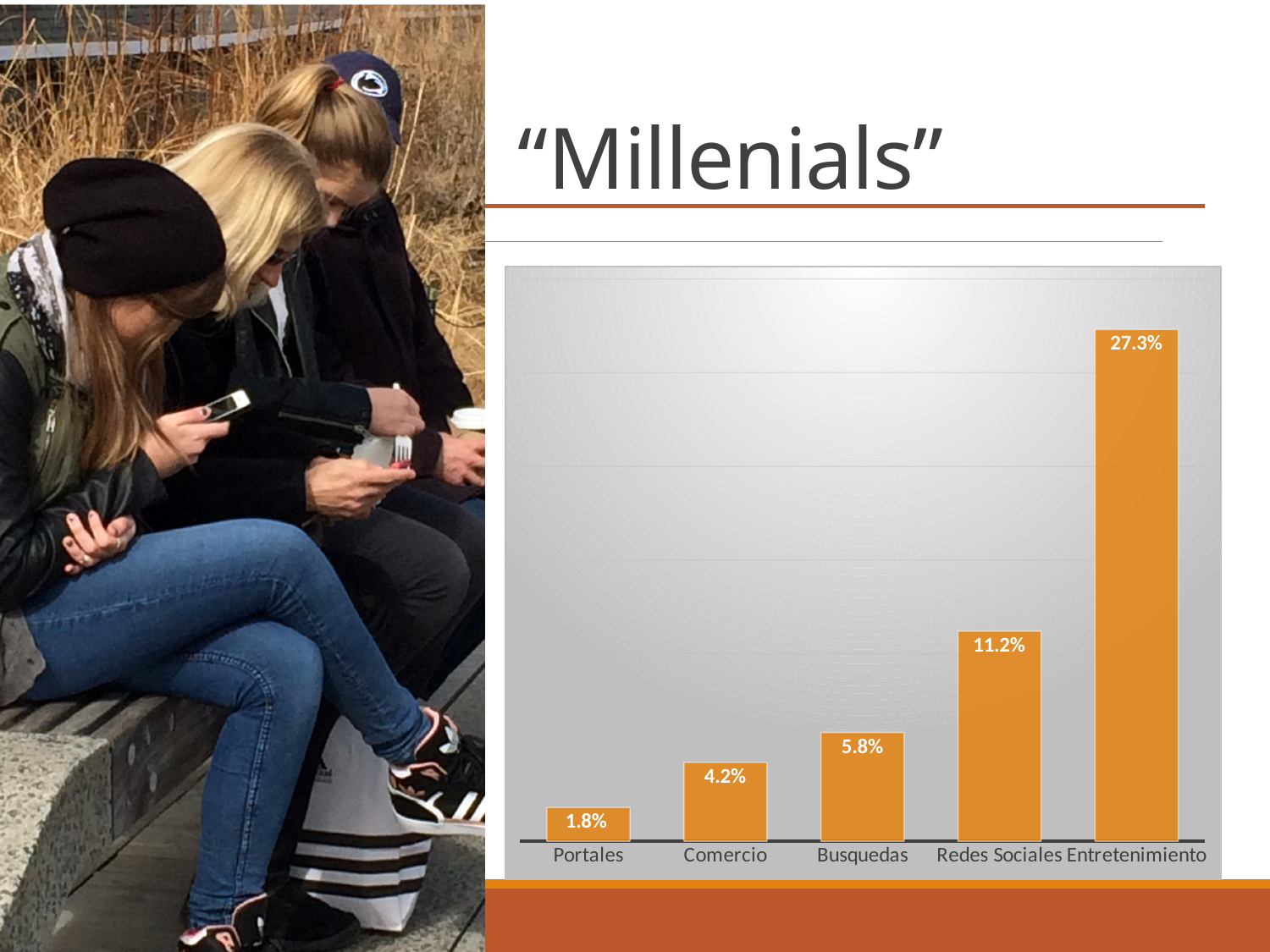
What kind of chart is shown on the slide? Bar chart What is the value for Entretenimiento? 27.3% What is the value for Redes Sociales? 11.2% What is the value for Portales? 1.8% What is the difference between the values for Entretenimiento and Redes Sociales? 16.1% What is the value for Busquedas? 5.8% Do the values rise or fall from left to right along the x axis? Rise Which category has the lowest value? Portales Which category has the highest value? Entretenimiento Which is larger, the value for Busquedas or the value for Comercio? Busquedas What is the difference between the values for Comercio and Portales? 2.4% How many categories are shown in the chart? 5